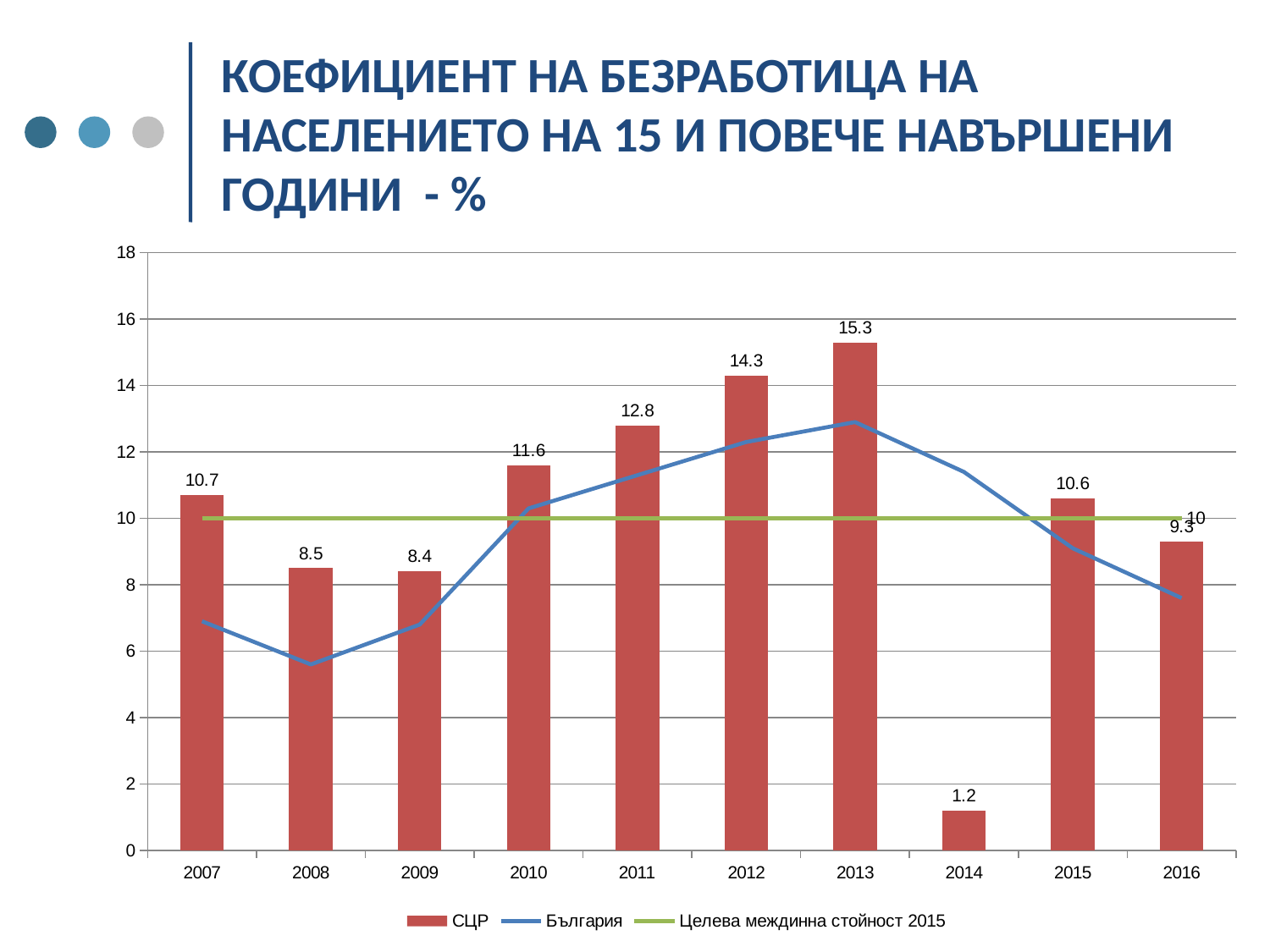
What is the difference between the СЦР values for 2013 and 2012? 1 What is the value of the СЦР bar for 2016? 9.3 What is the value of the СЦР bar for 2013? 15.3 Which year has the lowest СЦР bar? 2014 How many series does the legend list? 3 Is the value of the България line for 2013 greater or less than 12? greater What is the value of the СЦР bar for 2010? 11.6 How many years are shown on the x axis? 10 Which is larger, the СЦР value for 2011 or for 2015? 2011 What is the difference between the СЦР values for 2007 and 2008? 2.2 Is the value of the България line for 2008 greater or less than 8? less Which year has the highest СЦР bar? 2013